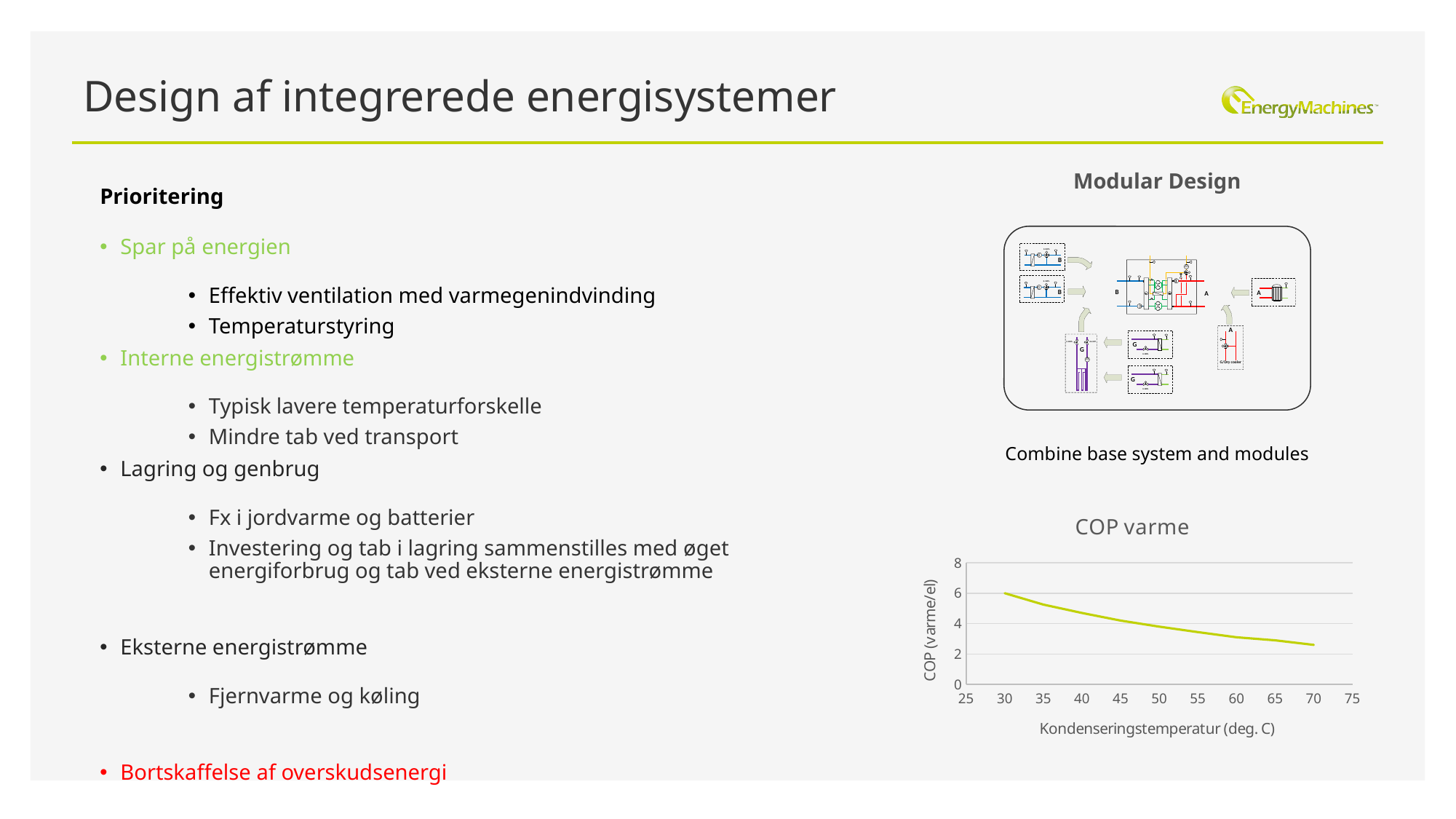
In the "COP varme" chart, at which condensing temperature shown on the line is the COP lowest? 70 In the "COP varme" chart, is the COP value at 50 deg. C greater or less than 2? greater In the "COP varme" chart, is the COP value at 30 deg. C greater or less than 4? greater In the "COP varme" chart, which has the higher COP: 30 deg. C or 70 deg. C? 30 deg. C What is the title of the chart on the slide? COP varme In the "COP varme" chart, does the COP rise or fall as the condensing temperature increases along the x axis? fall In the "COP varme" chart, is the COP value at 70 deg. C greater or less than 4? less In the "COP varme" chart, at which condensing temperature shown on the line is the COP highest? 30 What kind of chart is the "COP varme" chart? line chart What is the x-axis label of the "COP varme" chart? Kondenseringstemperatur (deg. C)